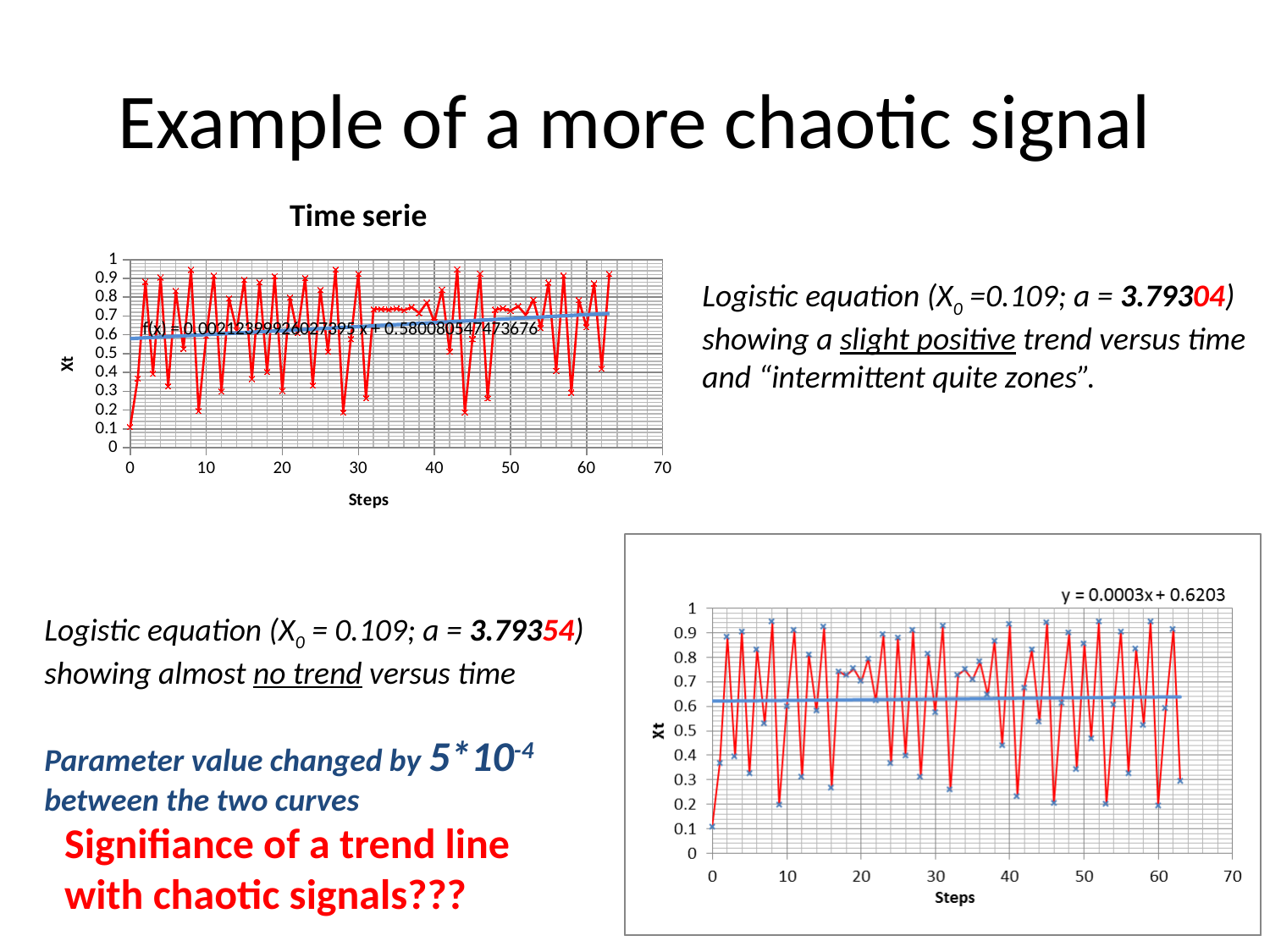
What is the highest tick value shown on the x axis of the bottom-right chart? 70 In the bottom-right chart, what trend line equation is printed on the chart? y = 0.0003x + 0.6203 What kind of chart is the top-left chart titled "Time serie"? line chart In the bottom-right chart, is the value at step 0 greater or less than 0.5? less In the top-left chart "Time serie", is the value at step 0 greater or less than 0.5? less What is the title of the top-left chart? Time serie In the bottom-right chart, what is the label of the x axis? Steps In the top-left chart "Time serie", does the fitted trend line rise or fall along the x axis? rise In the bottom-right chart, is the lowest plotted value greater or less than 0.2? less What is the highest tick value shown on the y axis of the top-left chart "Time serie"? 1